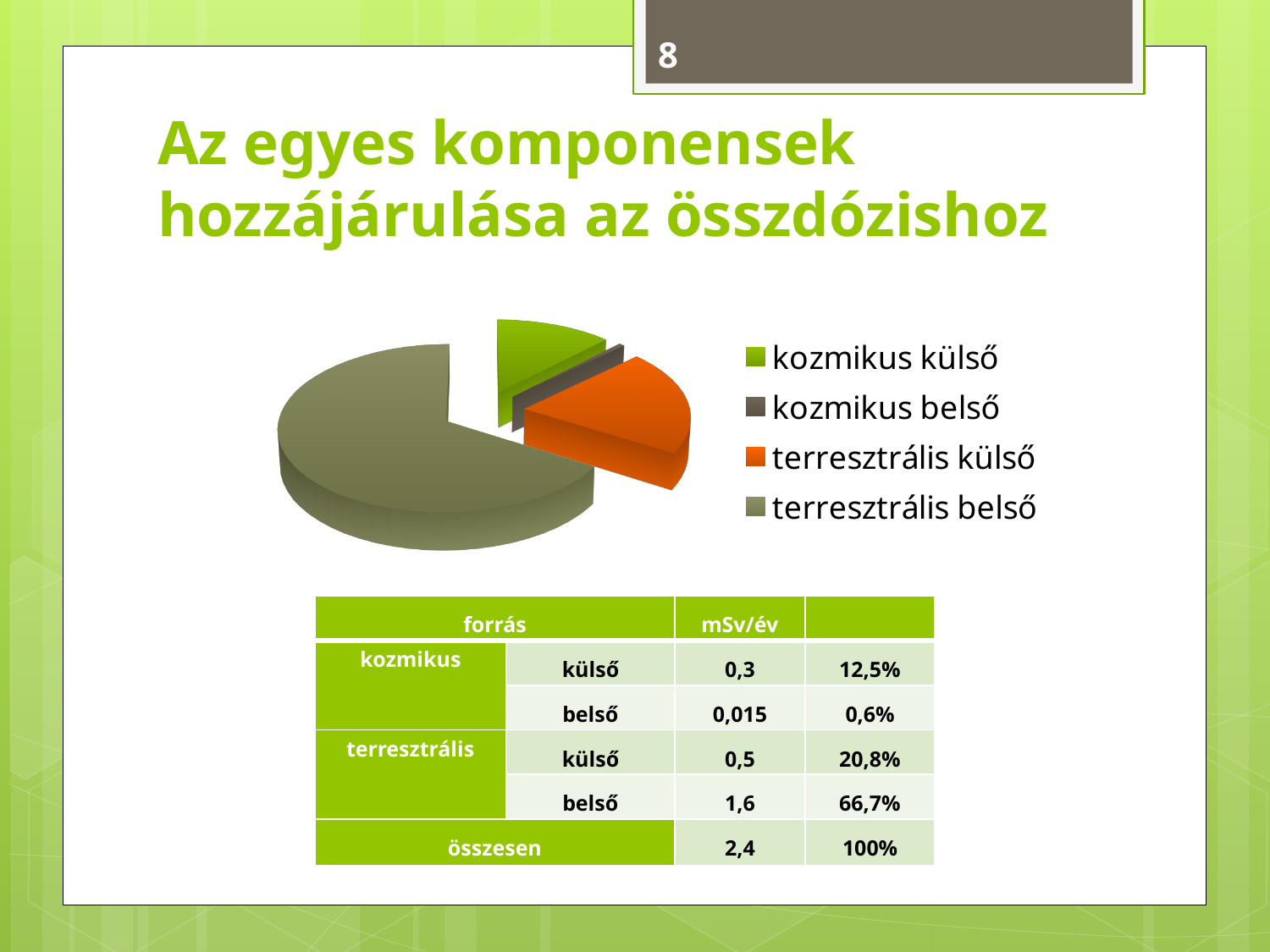
What kind of chart is shown on the slide? pie chart What colour is the slice for terresztrális külső in the pie chart? orange Which slice is larger in the pie chart, terresztrális külső or kozmikus külső? terresztrális külső According to the table on the slide, what is the dose in mSv/év for terresztrális külső? 0,5 How many slices does the pie chart have? 4 Which legend entry is listed first in the pie chart's legend? kozmikus külső Which category has the smallest slice in the pie chart? kozmikus belső According to the table on the slide, what share of the total dose does kozmikus külső represent? 12,5% How many entries does the legend of the pie chart list? 4 According to the table on the slide, what share of the total dose does terresztrális belső represent? 66,7% According to the table on the slide, what is the total dose (összesen) in mSv/év? 2,4 Which category has the largest slice in the pie chart? terresztrális belső